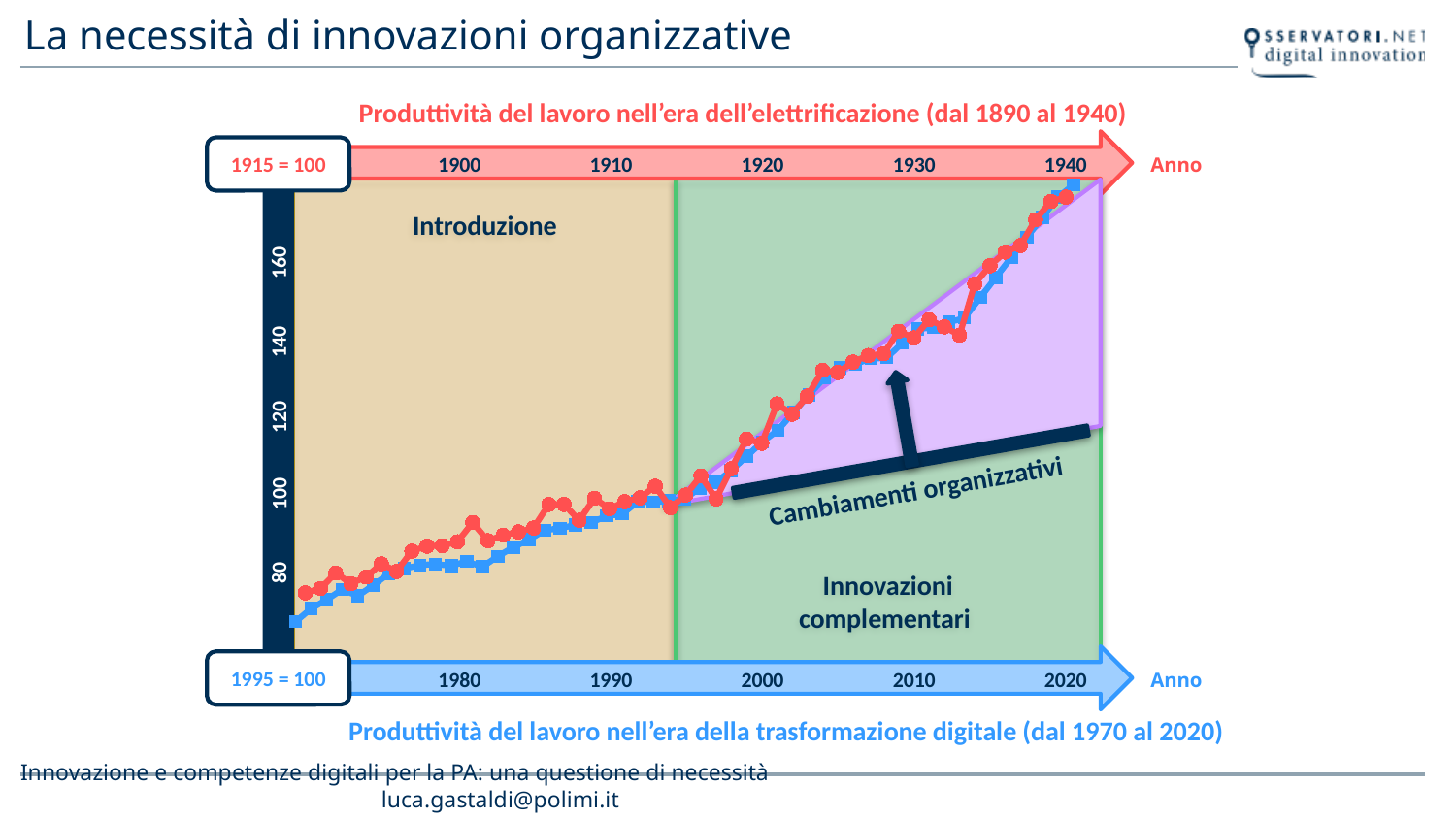
Is the value of the blue series at 2020 greater or less than 160? greater What kind of chart is shown on the slide? line chart Is the value of the blue series at 2010 greater or less than 120? greater Do the values of the blue series rise or fall from 1980 to 2020? rise In which year on the top axis does the red series reach its highest value? 1940 Is the value of the red series at 1940 greater or less than 160? greater What is the title of the red series shown above the chart? Produttività del lavoro nell'era dell'elettrificazione (dal 1890 al 1940) Do the values of the red series rise or fall from 1900 to 1940? rise Which year is set equal to 100 for the blue series, according to the label on the bottom axis? 1995 How many data series are plotted on the chart? 2